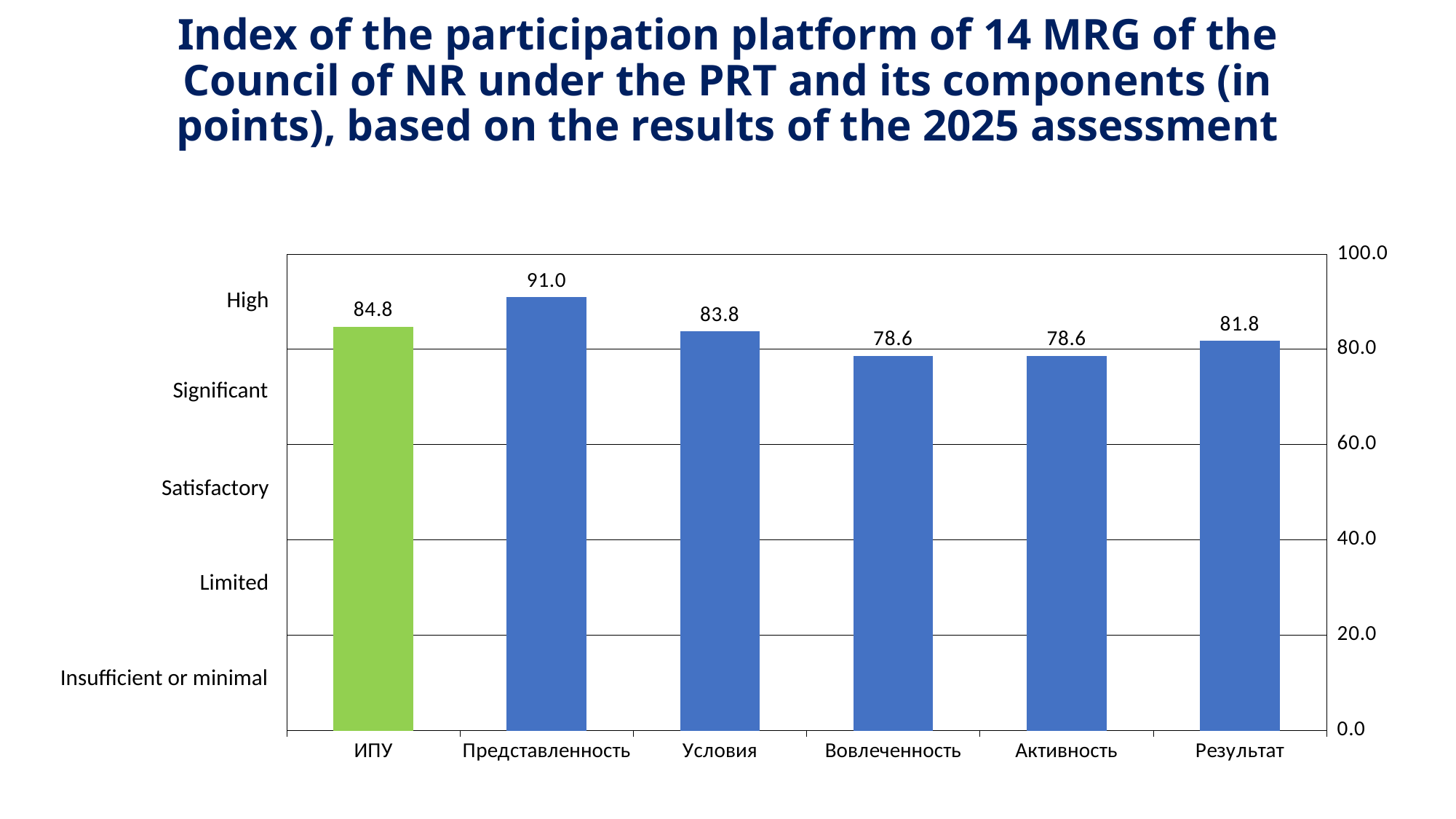
What is the difference between the values for Представленность and Условия? 7.2 Which bar is coloured green rather than blue? ИПУ What is the difference between the values for ИПУ and Вовлеченность? 6.2 What is the value for Представленность? 91.0 How many categories are shown on the x axis? 6 What kind of chart is shown on the slide? bar chart Is the value for Активность greater or less than 80.0? less What is the value for Результат? 81.8 Which category has the highest value? Представленность Is the value for Представленность greater or less than 80.0? greater Which is larger, the value for Условия or the value for Результат? Условия What is the value for ИПУ? 84.8